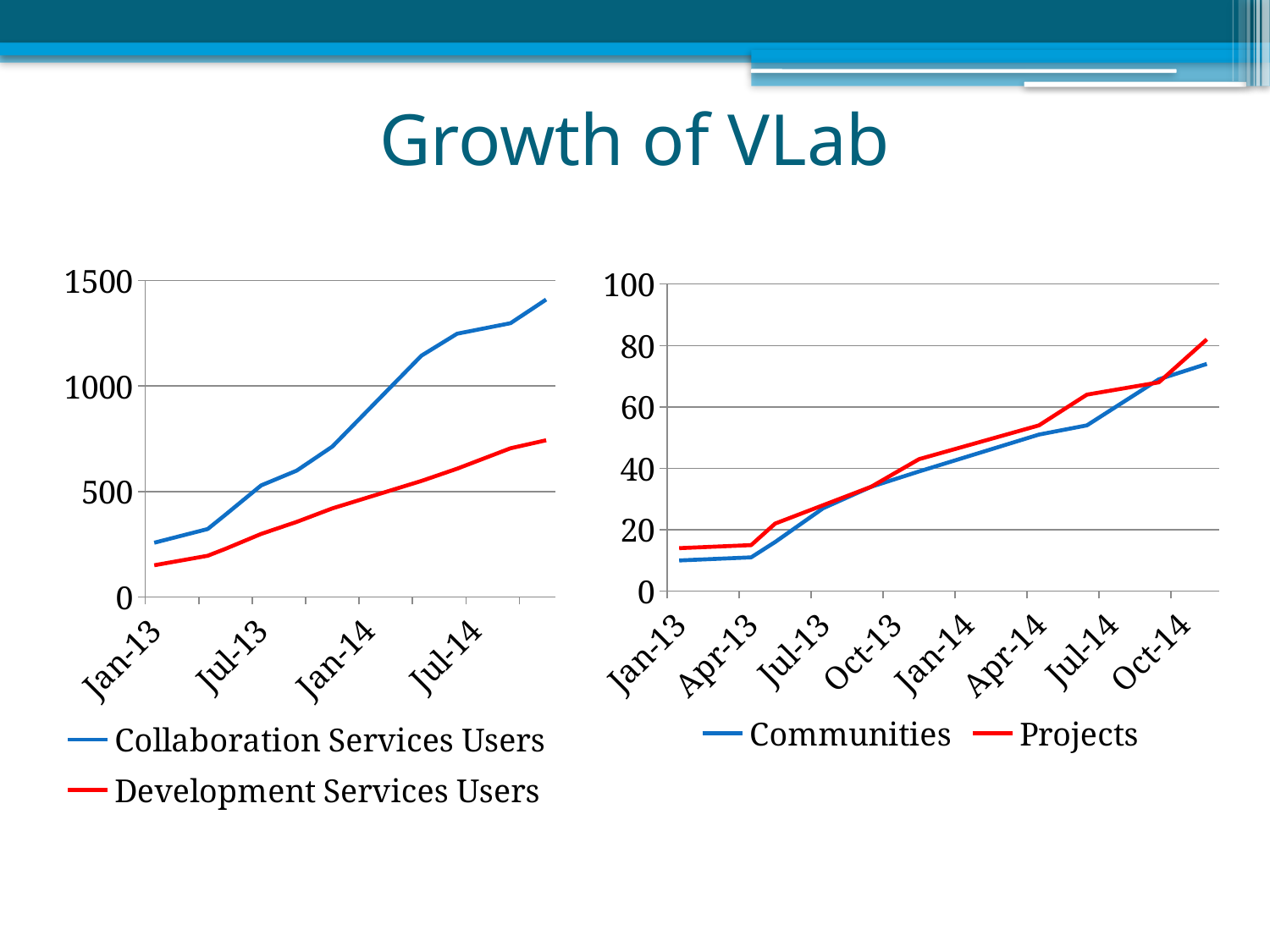
In the left chart, which series has the larger value at Jul-14, Collaboration Services Users or Development Services Users? Collaboration Services Users How many series does the legend of the left chart list? 2 In the left chart, do the Collaboration Services Users values rise or fall from Jan-13 to Jul-14? rise In the right chart, do the Communities values rise or fall from Jan-13 to Oct-14? rise In the right chart, is the value for Projects at Oct-14 greater or less than 60? greater In the left chart, is the value for Collaboration Services Users at Jul-14 greater or less than 1000? greater In the right chart, is the value for Communities at Jan-13 greater or less than 20? less How many x-axis labels are shown on the right chart? 8 What kind of chart is the left chart on the slide? line chart In the right chart, which series has the larger value at Oct-14, Communities or Projects? Projects How many series does the legend of the right chart list? 2